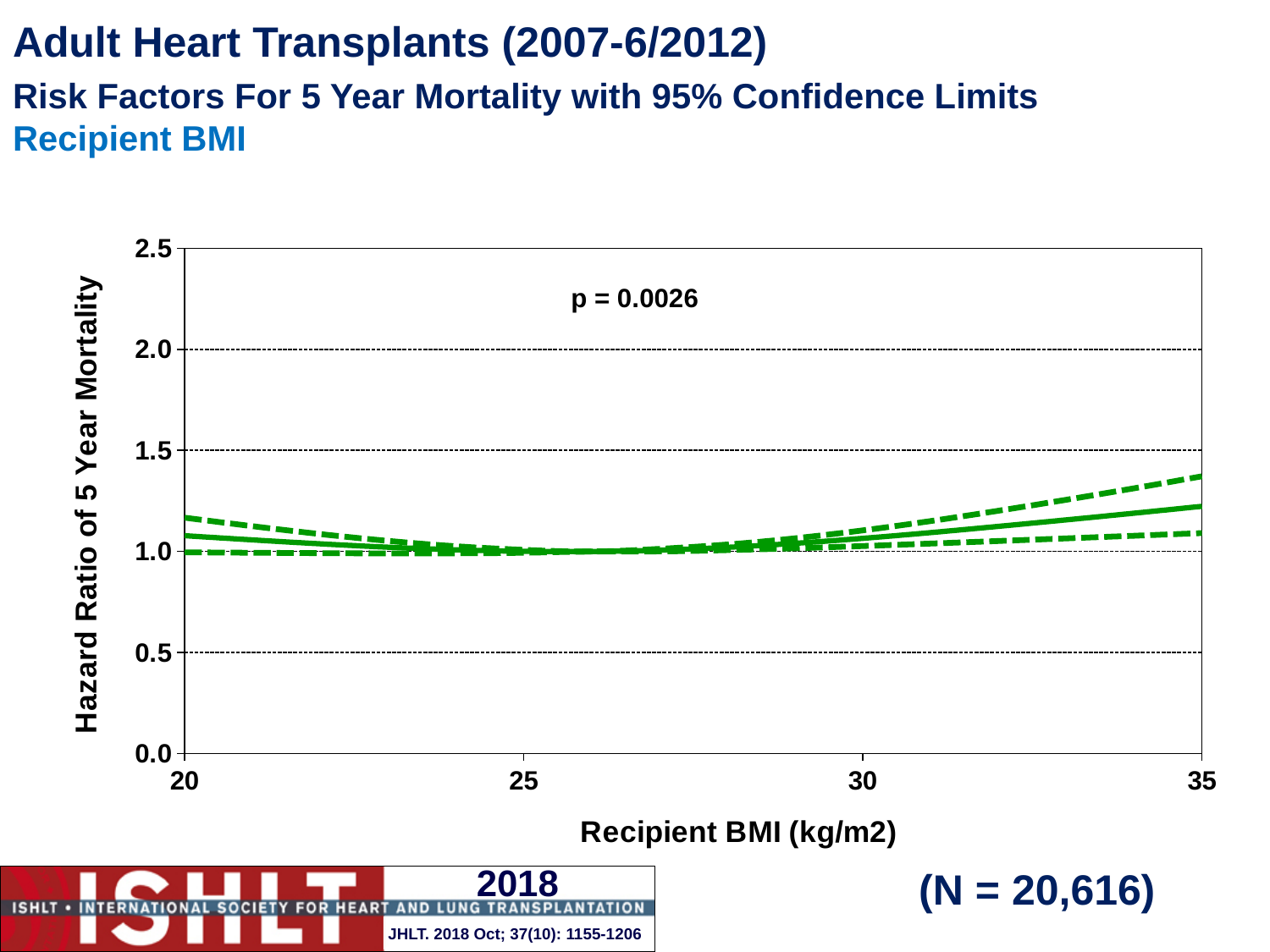
Does the solid hazard ratio line rise or fall as recipient BMI increases from 20 to 25? falls What kind of chart is shown on the slide? line chart Is the upper confidence limit at a recipient BMI of 35 greater or less than 1.5? less What is the lowest recipient BMI value shown on the x-axis? 20 How many lines are plotted on the chart? 3 What sample size (N) is shown on the slide? N = 20,616 Is the hazard ratio of the solid line at a recipient BMI of 30 greater or less than 1.5? less Does the solid hazard ratio line rise or fall as recipient BMI increases from 25 to 35? rises Is the hazard ratio of the solid line at a recipient BMI of 35 greater or less than 1.5? less What is the highest value shown on the y-axis? 2.5 What p-value is printed on the chart? p = 0.0026